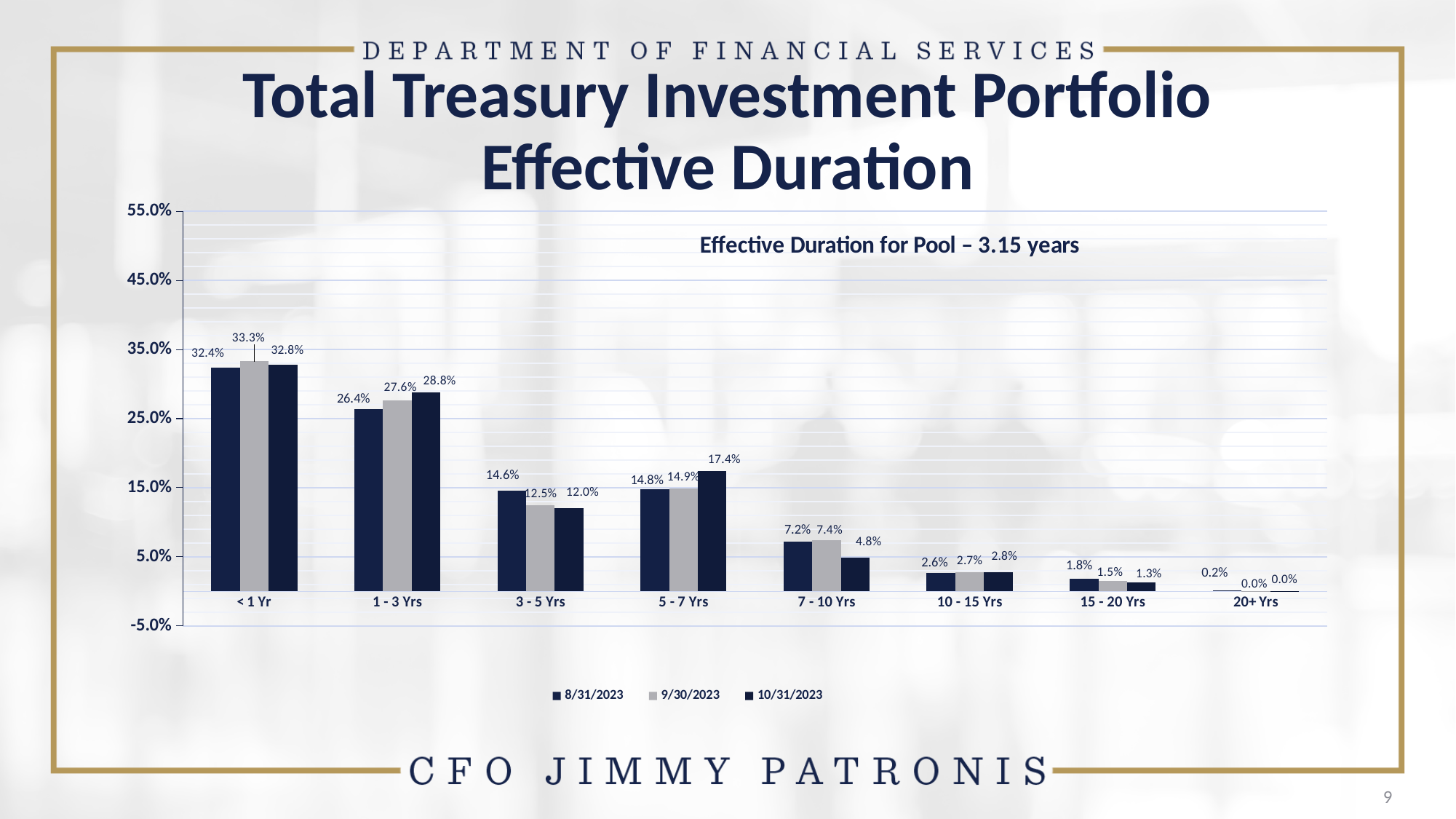
How many categories are shown on the x axis? 8 What is the difference between the 10/31/2023 and 8/31/2023 values for the 5 - 7 Yrs category? 2.6% What is the value for the 7 - 10 Yrs category in the 9/30/2023 series? 7.4% Which category has the lowest value in the 8/31/2023 series? 20+ Yrs How many series does the legend list? 3 For the 3 - 5 Yrs category, which series has the larger value, 8/31/2023 or 10/31/2023? 8/31/2023 What kind of chart is shown on the slide? bar chart Which category has the highest value in the 9/30/2023 series? < 1 Yr What is the value for the 5 - 7 Yrs category in the 8/31/2023 series? 14.8% Is the 10/31/2023 value for the 1 - 3 Yrs category greater or less than 25.0%? greater What effective duration for the pool is stated on the chart? 3.15 years What is the value for the 1 - 3 Yrs category in the 10/31/2023 series? 28.8%